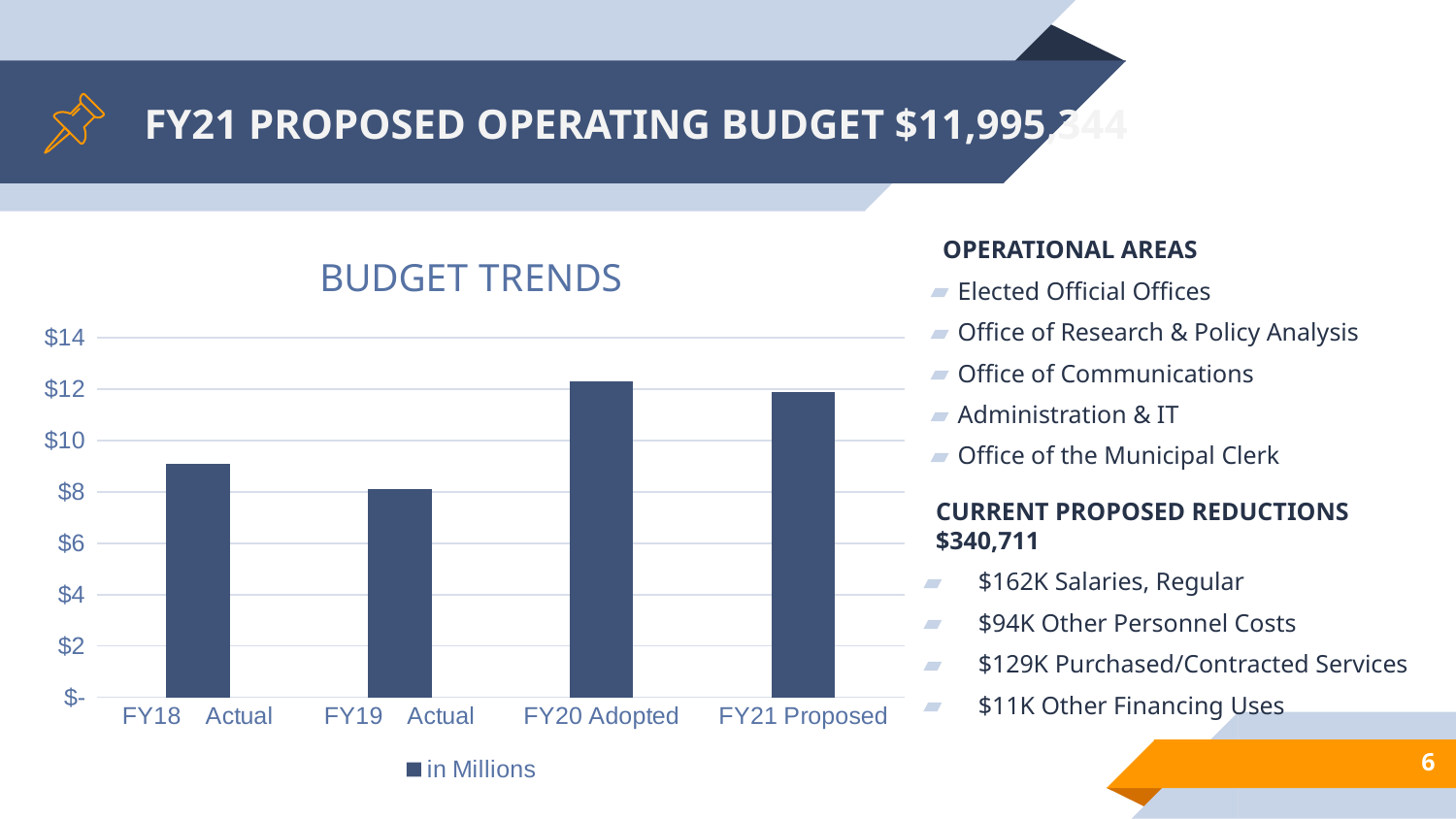
Is the value for FY18 Actual greater or less than $8? greater How many categories are shown on the x axis of the chart? 4 Is the value for FY19 Actual greater or less than $10? less How many series does the chart legend list? 1 What kind of chart is shown on the slide? bar chart Which category has the highest value in the chart? FY20 Adopted What is the title of the chart? BUDGET TRENDS What is the legend entry for the series in the chart? in Millions Is the value for FY21 Proposed greater or less than $10? greater Which category has the lowest value in the chart? FY19 Actual Which is larger, the value for FY18 Actual or FY19 Actual? FY18 Actual